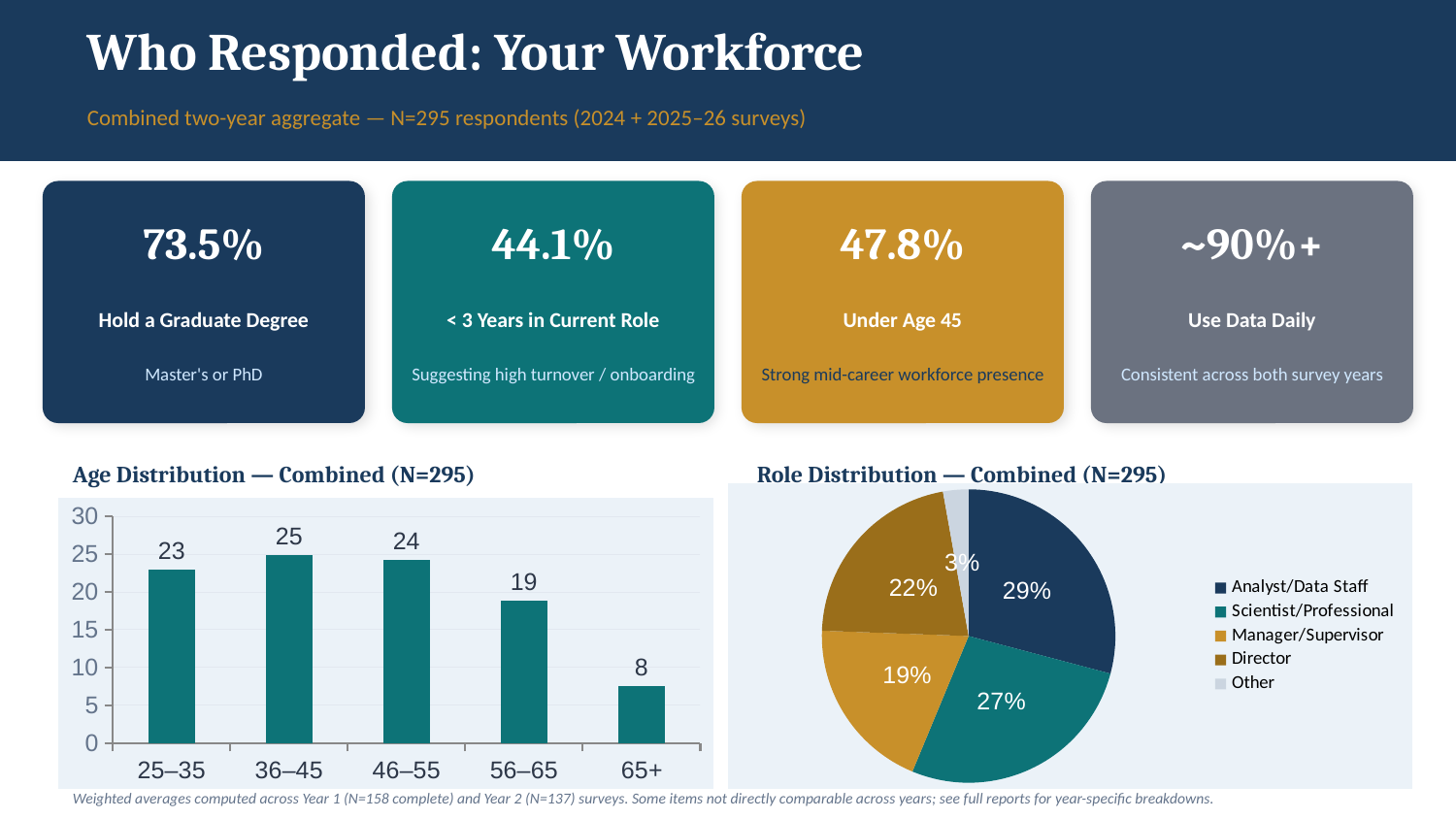
In the Age Distribution chart, what is the value for the 65+ age group? 8 In the Age Distribution chart, which age group has the lowest value? 65+ In the Age Distribution chart, which age group has the highest value? 36–45 In the Role Distribution chart, which role has the smallest slice? Other In the Age Distribution chart, what is the value for the 36–45 age group? 25 In the Age Distribution chart, what is the difference between the values for 25–35 and 56–65? 4 How many age groups are shown in the Age Distribution chart? 5 What kind of chart is the Age Distribution — Combined (N=295) chart? Bar chart In the Role Distribution chart, what share of the pie is Director? 22% In the Age Distribution chart, which is larger: the value for 46–55 or the value for 56–65? 46–55 How many entries does the legend of the Role Distribution chart list? 5 In the Role Distribution chart, what share of the pie is Analyst/Data Staff? 29%